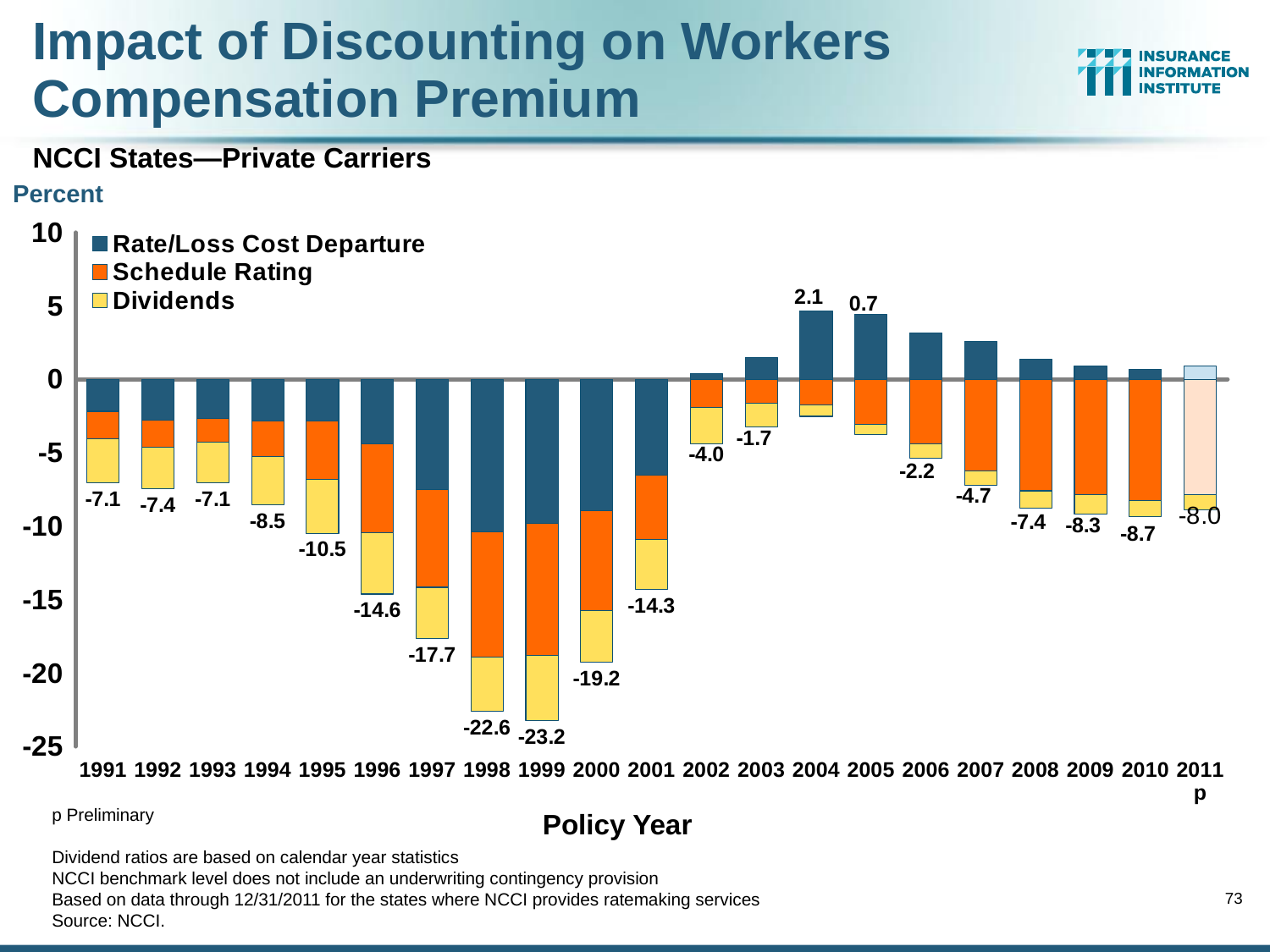
What is the total labeled value for policy year 2011p? -8.0 What kind of chart is shown on the slide? Stacked bar chart Which policy year has a larger total value, 2005 or 2006? 2005 What is the difference between the total values for 1998 and 2000? 3.4 Is the total value for 1997 greater or less than -15? less What is the total labeled value for policy year 2004? 2.1 Which policy year has the highest total value? 2004 What is the total labeled value for policy year 1999? -23.2 How many policy years are shown on the x axis? 21 Do the total values rise or fall from 1999 to 2004? rise Which policy year has the lowest (most negative) total value? 1999 How many series does the legend list? 3